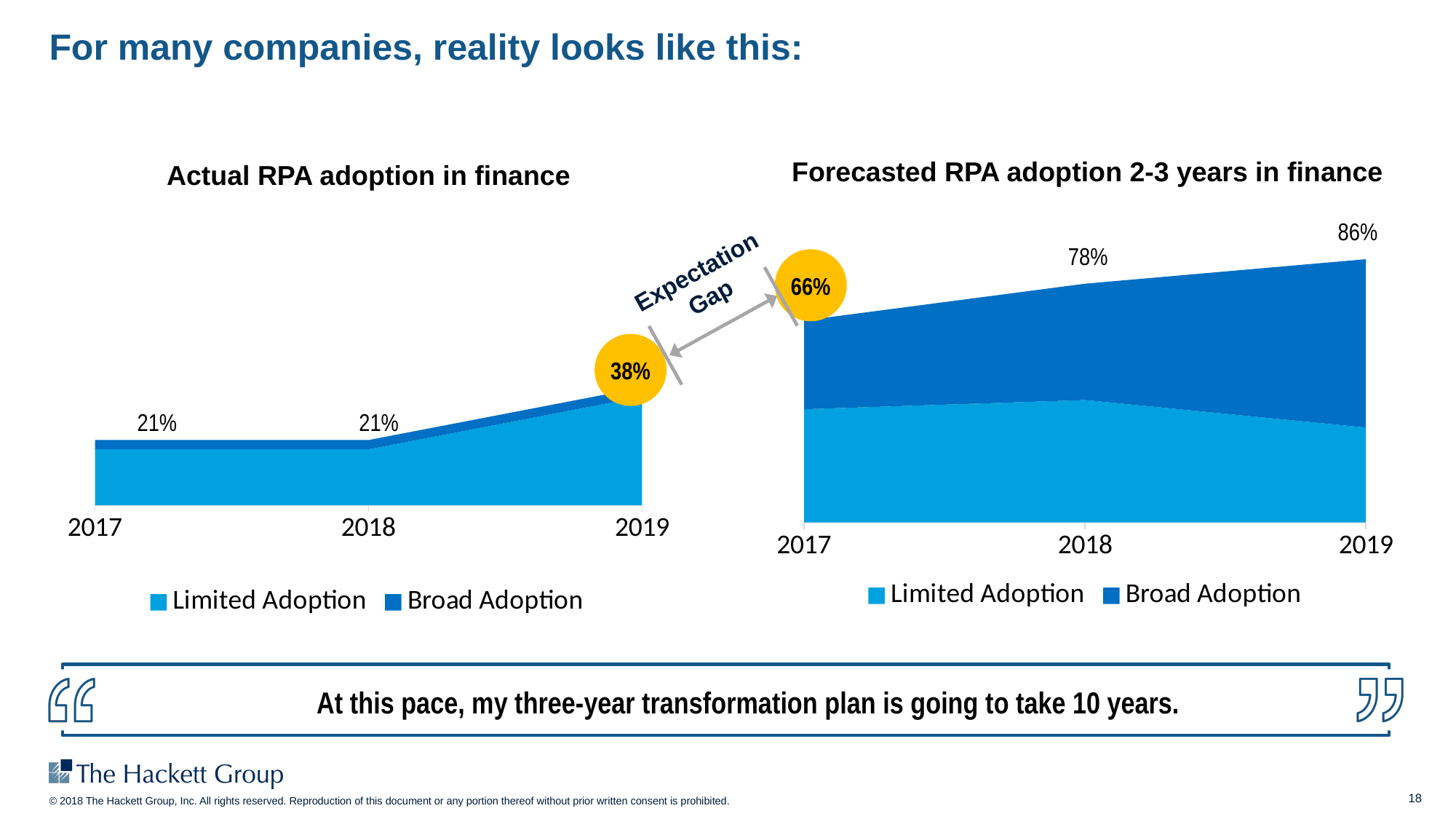
How many series does the legend of the 'Forecasted RPA adoption 2-3 years in finance' chart list? 2 In the 'Actual RPA adoption in finance' chart, which year has the highest labelled total? 2019 In the 'Actual RPA adoption in finance' chart, what is the total adoption value labelled for 2019? 38% In the 'Actual RPA adoption in finance' chart, what is the difference between the labelled totals for 2019 and 2018? 17% In the 'Forecasted RPA adoption 2-3 years in finance' chart, what is the total adoption value labelled for 2017? 66% Which is larger: the 2019 total in the 'Actual RPA adoption in finance' chart or the 2017 total in the 'Forecasted RPA adoption 2-3 years in finance' chart? The 2017 forecasted total (66%) How many years are shown on the x axis of the 'Actual RPA adoption in finance' chart? 3 In the 'Forecasted RPA adoption 2-3 years in finance' chart, what is the difference between the labelled totals for 2018 and 2017? 12% In the 'Actual RPA adoption in finance' chart, what is the total adoption value labelled for 2017? 21% In the 'Forecasted RPA adoption 2-3 years in finance' chart, what is the total adoption value labelled for 2019? 86% In the 'Forecasted RPA adoption 2-3 years in finance' chart, which year has the highest labelled total? 2019 In the 'Forecasted RPA adoption 2-3 years in finance' chart, do the labelled totals rise or fall from 2017 to 2019? Rise